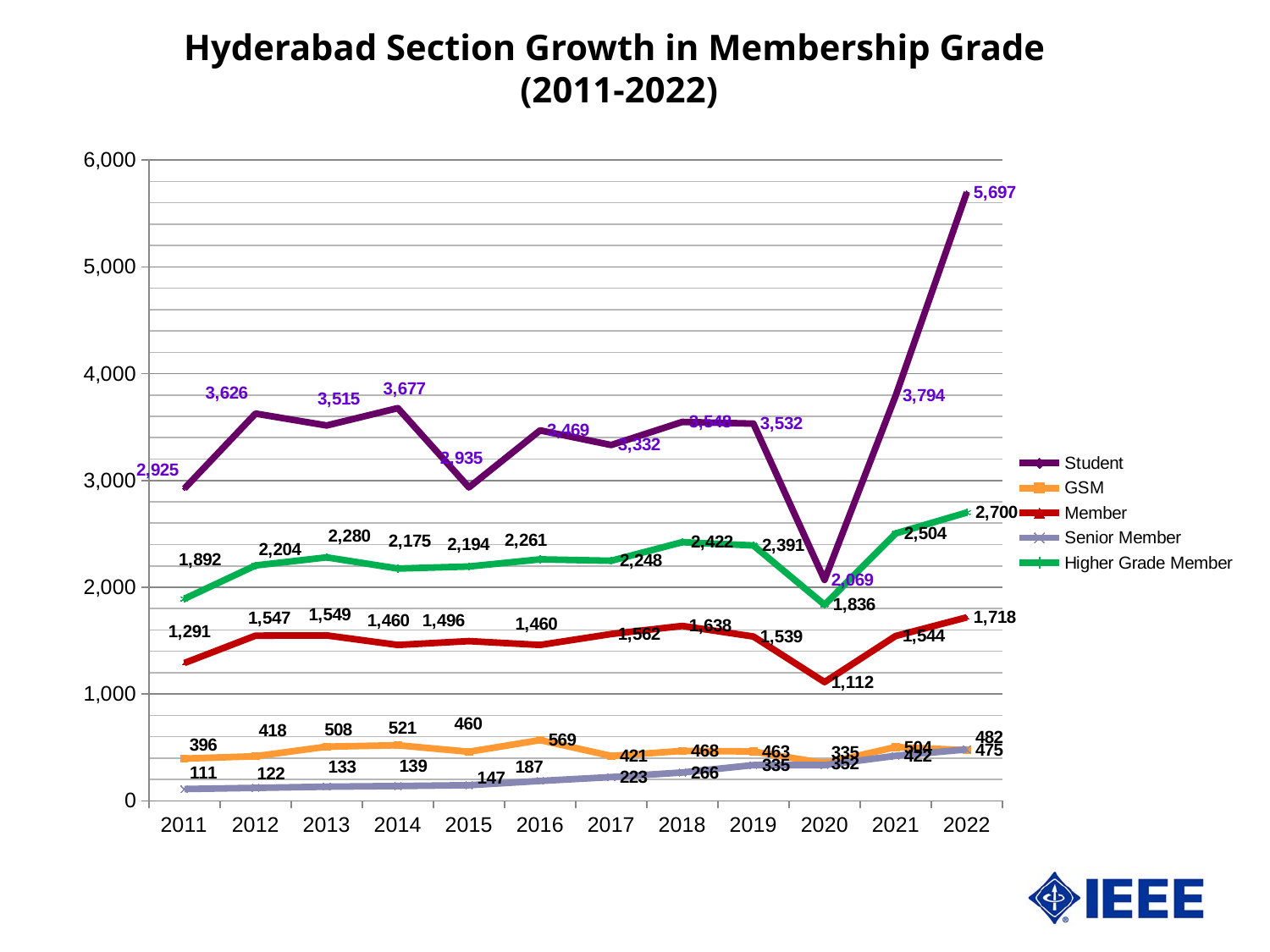
In which year is the Student series at its lowest? 2020 What is the Senior Member value in 2011? 111 What is the Student membership value in 2022? 5,697 Which year has the larger Member value, 2018 or 2019? 2018 What is the difference between the Student values in 2022 and 2021? 1,903 How many years are plotted on the x axis? 12 What is the Higher Grade Member value in 2020? 1,836 What kind of chart is shown on the slide? Line chart In which year does the GSM series reach its highest value? 2016 How many series does the legend list? 5 What is the difference between the Higher Grade Member values in 2022 and 2011? 808 In which year is the Member series at its lowest? 2020